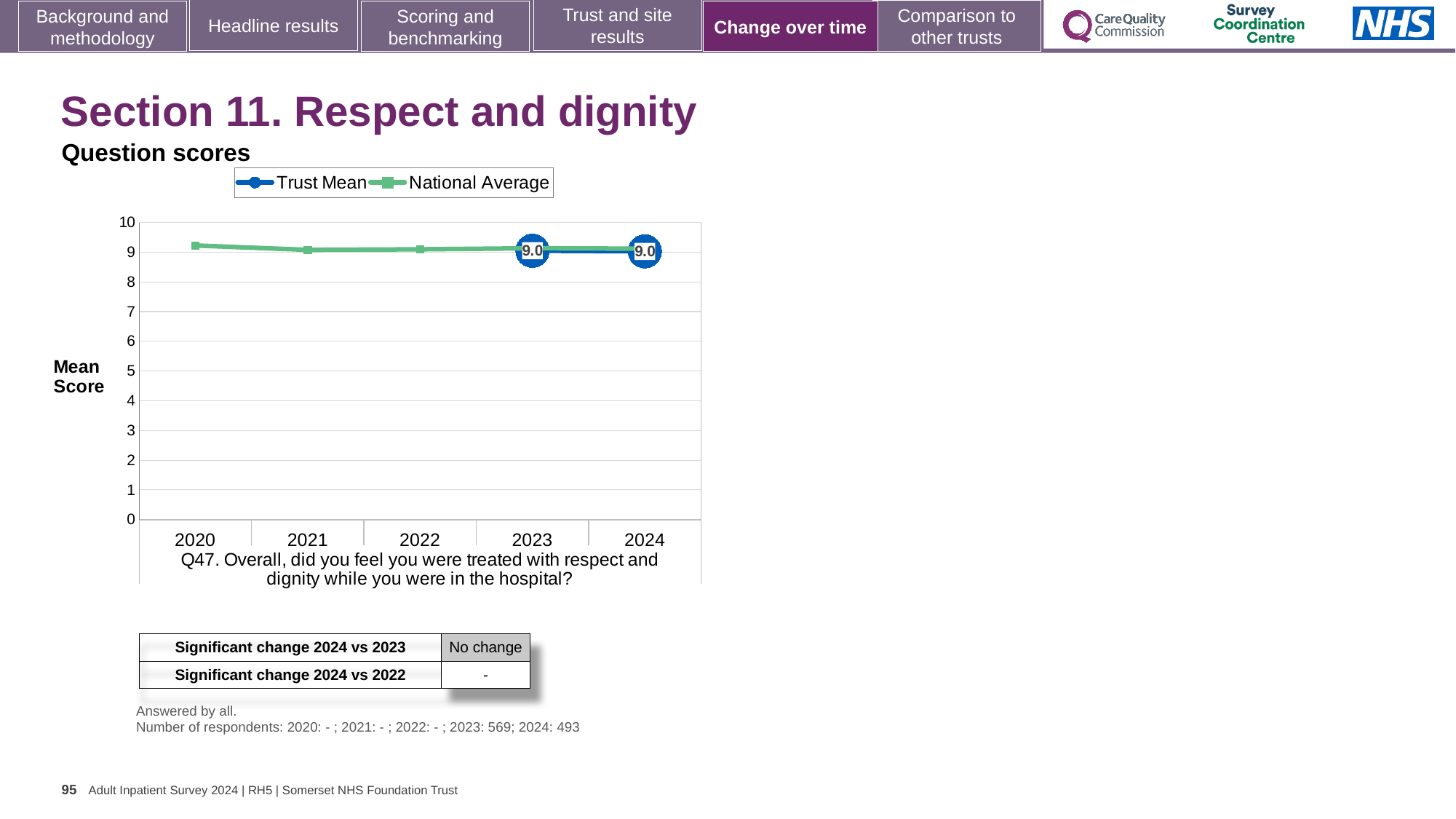
What is the Trust Mean value for 2023? 9.0 Does the Trust Mean rise, fall or stay the same from 2023 to 2024? Stays the same Is the National Average value for 2020 greater or less than 8? greater What is the Trust Mean value for 2024? 9.0 What is the difference between the Trust Mean values for 2024 and 2023? 0.0 What kind of chart is shown on the slide? Line chart Which two series are listed in the chart legend? Trust Mean and National Average What is the first year shown on the x axis? 2020 Is the National Average value for 2022 greater or less than 10? less How many series does the legend list? 2 How many years are shown on the x axis? 5 What is the label on the y axis of the chart? Mean Score